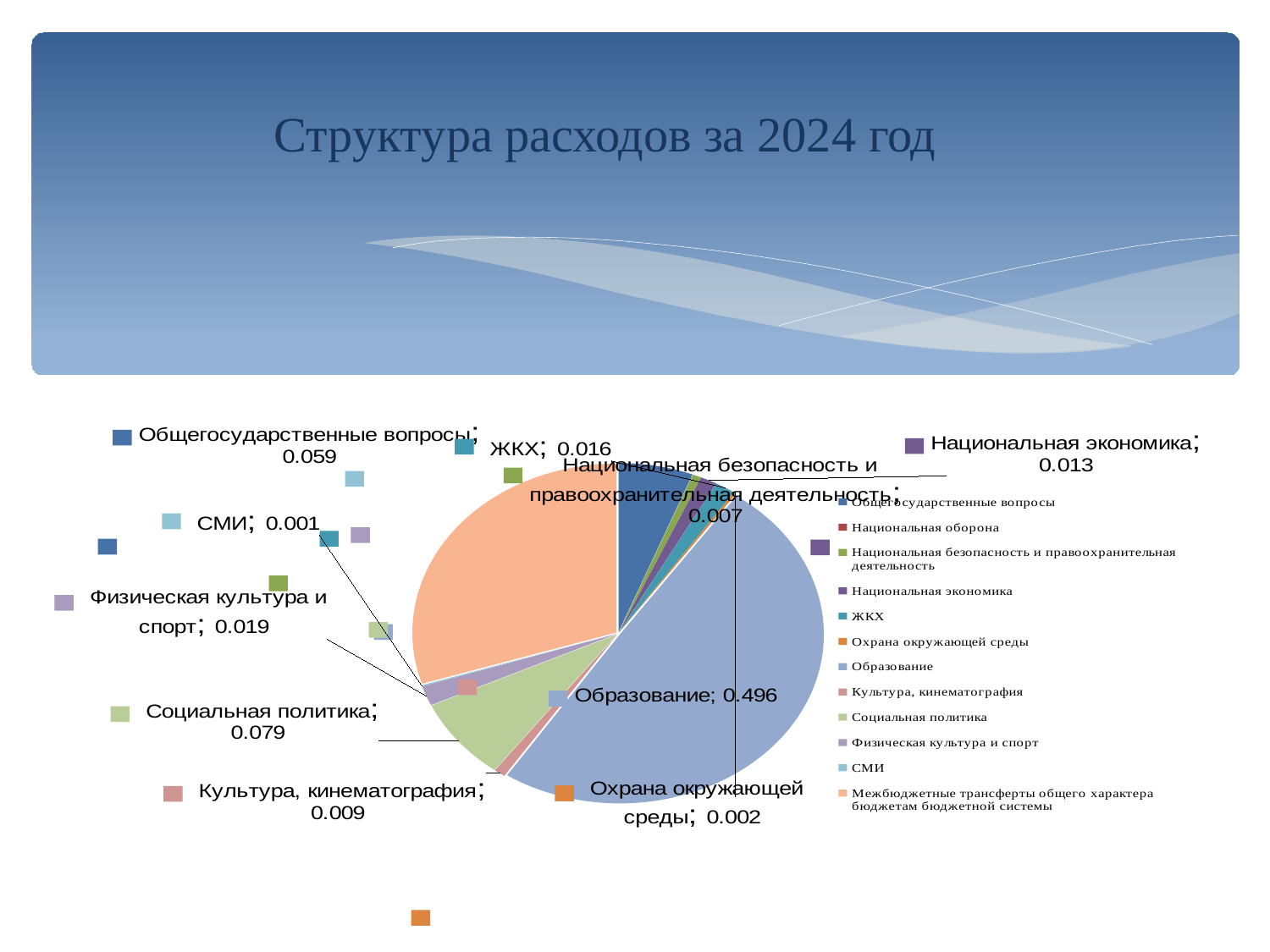
What is the value shown for Общегосударственные вопросы? 0.059 What is the value shown for Физическая культура и спорт? 0.019 What is the difference between the values for Социальная политика and Общегосударственные вопросы? 0.020 What is the value shown for Образование? 0.496 What kind of chart is shown on the slide? pie chart Which category has the largest slice of the pie? Образование What is the value shown for Охрана окружающей среды? 0.002 What is the title of the slide's chart? Структура расходов за 2024 год How many categories does the legend list? 12 What is the value shown for ЖКХ? 0.016 Which is larger, the value for Социальная политика or the value for Общегосударственные вопросы? Социальная политика What is the value shown for Социальная политика? 0.079